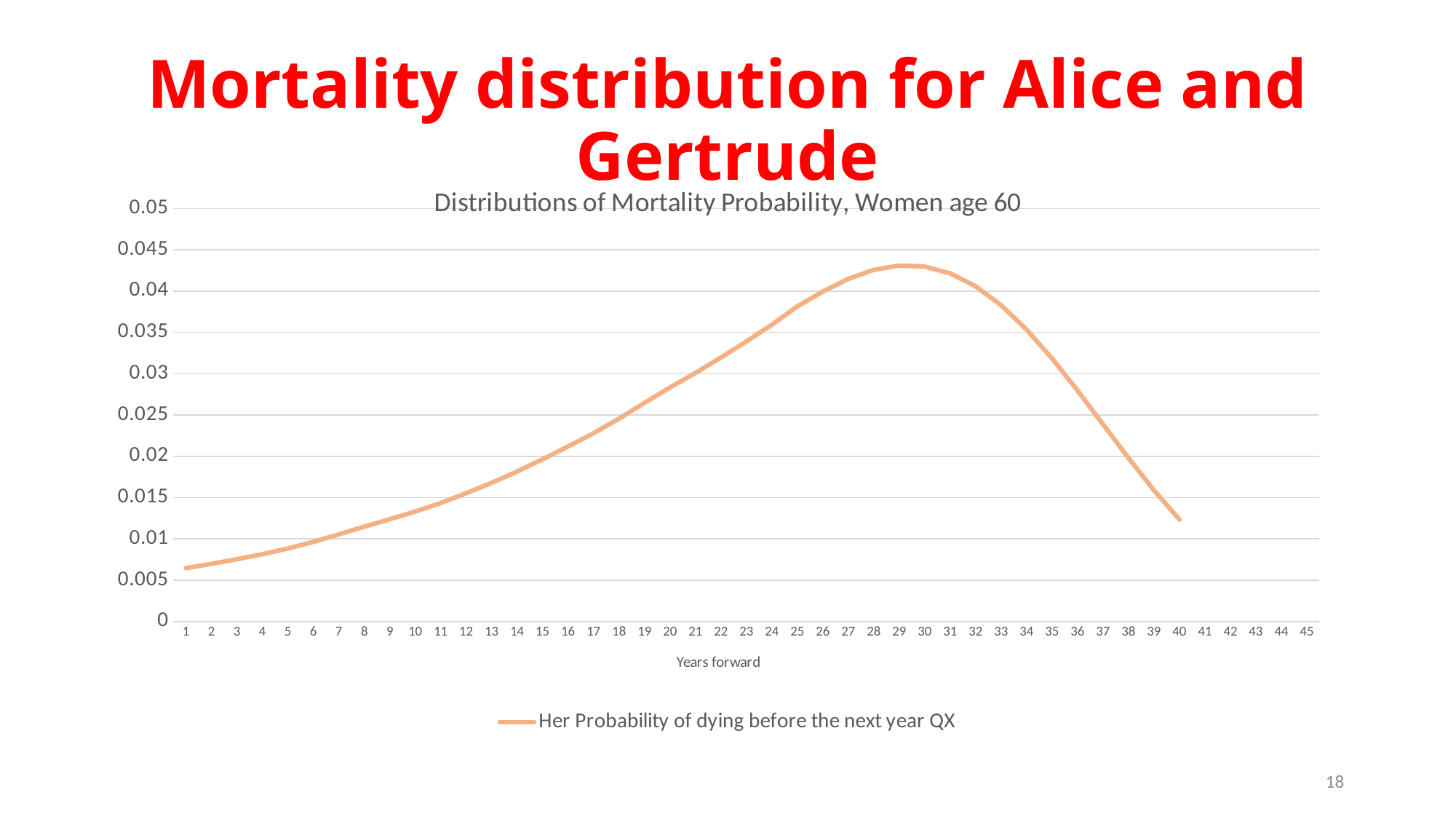
Is the value at year 10 greater or less than 0.01? greater What is the label of the x axis? Years forward Is the value at year 40 greater or less than 0.015? less Which has the larger value, year 10 or year 30? year 30 Does the line rise or fall between year 30 and year 40? fall What is the title of the chart? Distributions of Mortality Probability, Women age 60 At which year is the plotted value lowest? 1 What kind of chart is shown on the slide? line chart Is the value at year 25 greater or less than 0.035? greater How many series does the legend list? 1